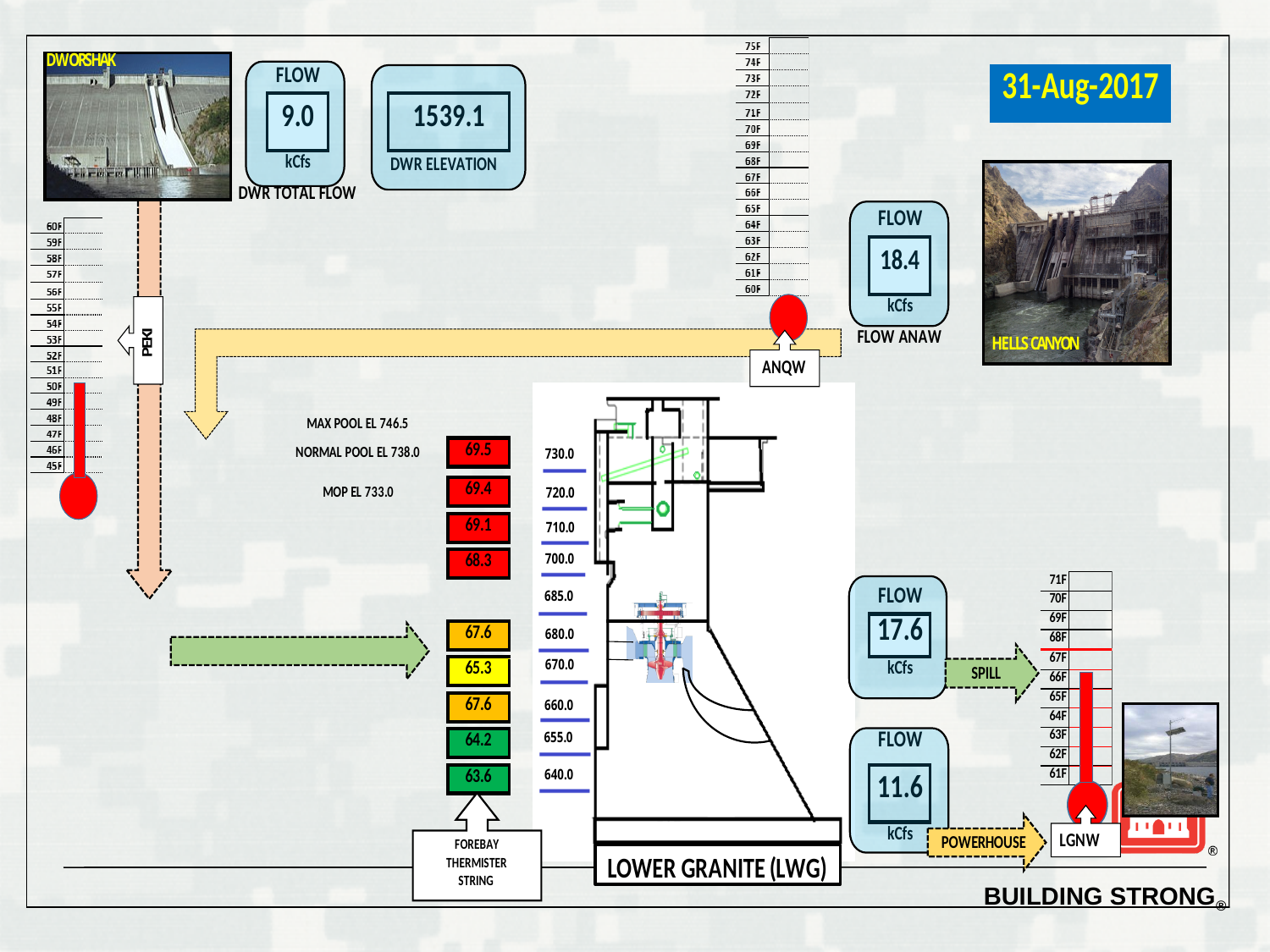
On the PEKI thermometer scale, is the reading greater or less than 55F? less What date is shown on the slide? 31-Aug-2017 What is the difference between the highest (69.5) and lowest (63.6) values in the forebay thermister string? 5.9 On the forebay thermister string, what is the topmost temperature value shown? 69.5 What is the flow value shown for ANAW? 18.4 kCfs What is the DWR elevation shown on the slide? 1539.1 What is the DWR total flow shown for Dworshak? 9.0 kCfs Which value in the forebay thermister string is the lowest? 63.6 On the forebay thermister string, what is the bottommost temperature value shown? 63.6 How many temperature values are listed in the forebay thermister string? 9 Which is larger at Lower Granite, the spill flow or the powerhouse flow? Spill flow (17.6 kCfs) What is the difference between the spill flow (17.6) and the powerhouse flow (11.6) at Lower Granite? 6.0 kCfs